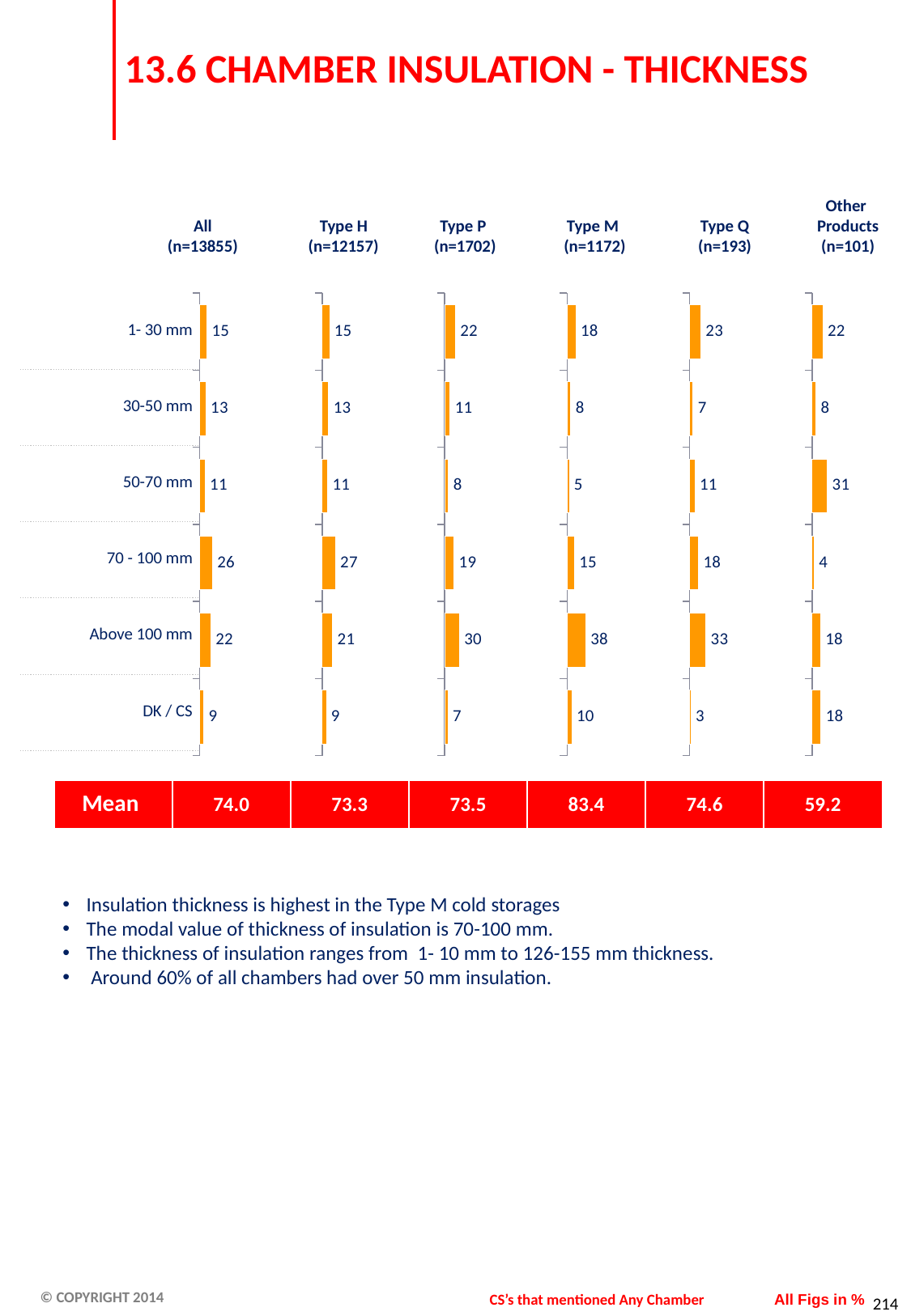
In the Type Q (n=193) chart, which category has the lowest value? DK / CS In the Other Products (n=101) chart, what is the value for 50-70 mm? 31 In the Type Q (n=193) chart, what is the difference between the Above 100 mm value and the 1- 30 mm value? 10 What kind of chart is used for the All (n=13855) data? Bar chart In the All (n=13855) chart, which category has the highest value? 70 - 100 mm In the Type P (n=1702) chart, what is the difference between the Above 100 mm value and the 1- 30 mm value? 8 In the Type M (n=1172) chart, what is the value for Above 100 mm? 38 In the Other Products (n=101) chart, what is the value for 70 - 100 mm? 4 What is the Mean value shown below the Type M (n=1172) chart? 83.4 How many separate bar charts are shown on the slide? 6 In the Type H (n=12157) chart, which is larger: the value for 70 - 100 mm or the value for Above 100 mm? 70 - 100 mm How many categories are shown in the Type M (n=1172) chart? 6